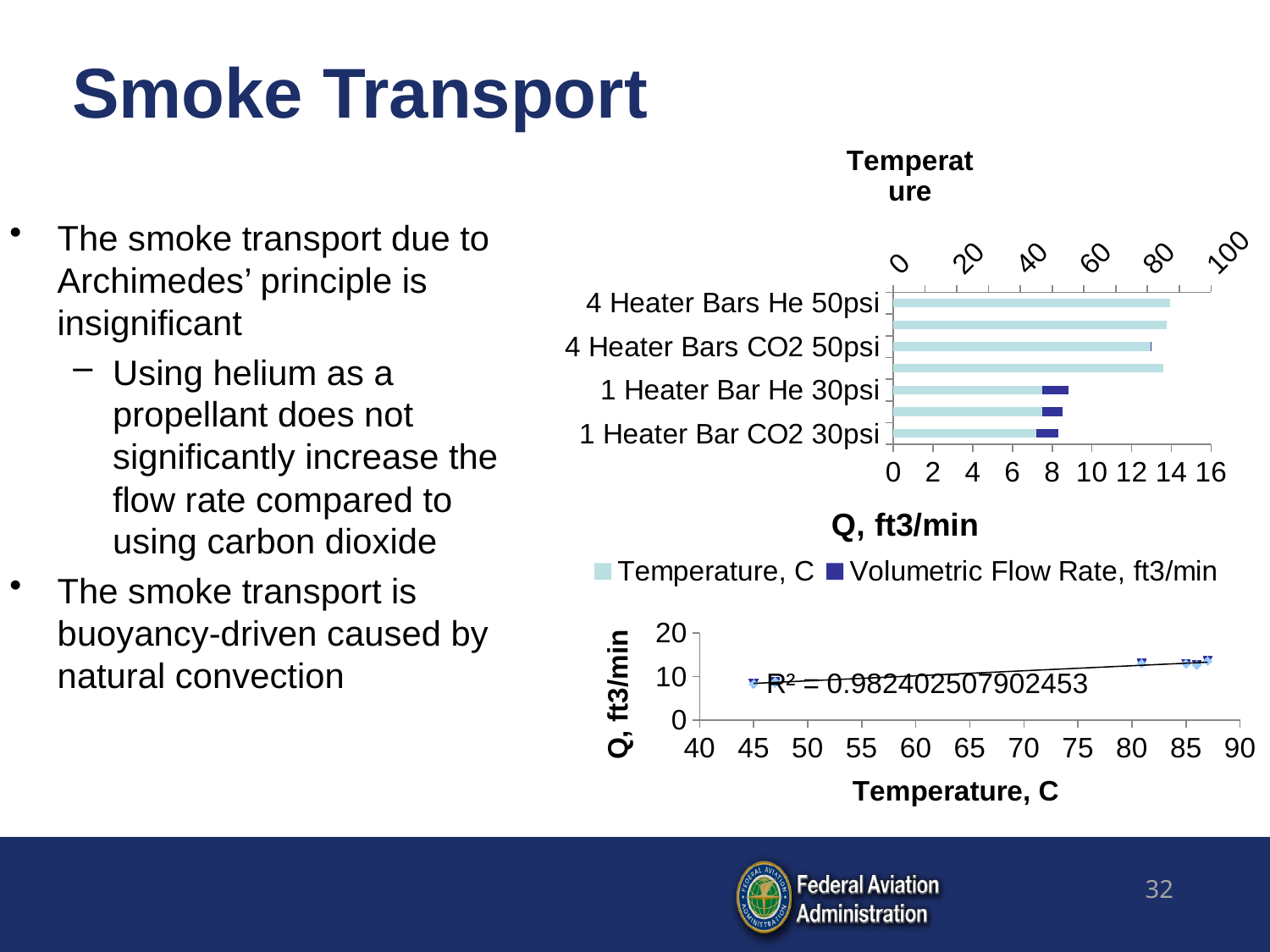
In the bottom scatter chart, does Q rise or fall as Temperature increases? rise What are the two legend entries of the top bar chart? Temperature, C and Volumetric Flow Rate, ft3/min In the top bar chart, which has the higher Temperature: 4 Heater Bars He 50psi or 1 Heater Bar CO2 30psi? 4 Heater Bars He 50psi What is the x-axis label of the bottom scatter chart? Temperature, C In the top bar chart, is the Volumetric Flow Rate for 1 Heater Bar He 30psi greater or less than 6? greater What kind of chart is the bottom chart on the slide? scatter chart In the top bar chart, is the Temperature value for 4 Heater Bars He 50psi greater or less than 80? greater In the top bar chart, is the Volumetric Flow Rate for 1 Heater Bar CO2 30psi greater or less than 10? less What kind of chart is the top chart on the slide? bar chart In the bottom scatter chart, what R² value is printed for the trendline? R² = 0.982402507902453 How many series does the legend of the top bar chart list? 2